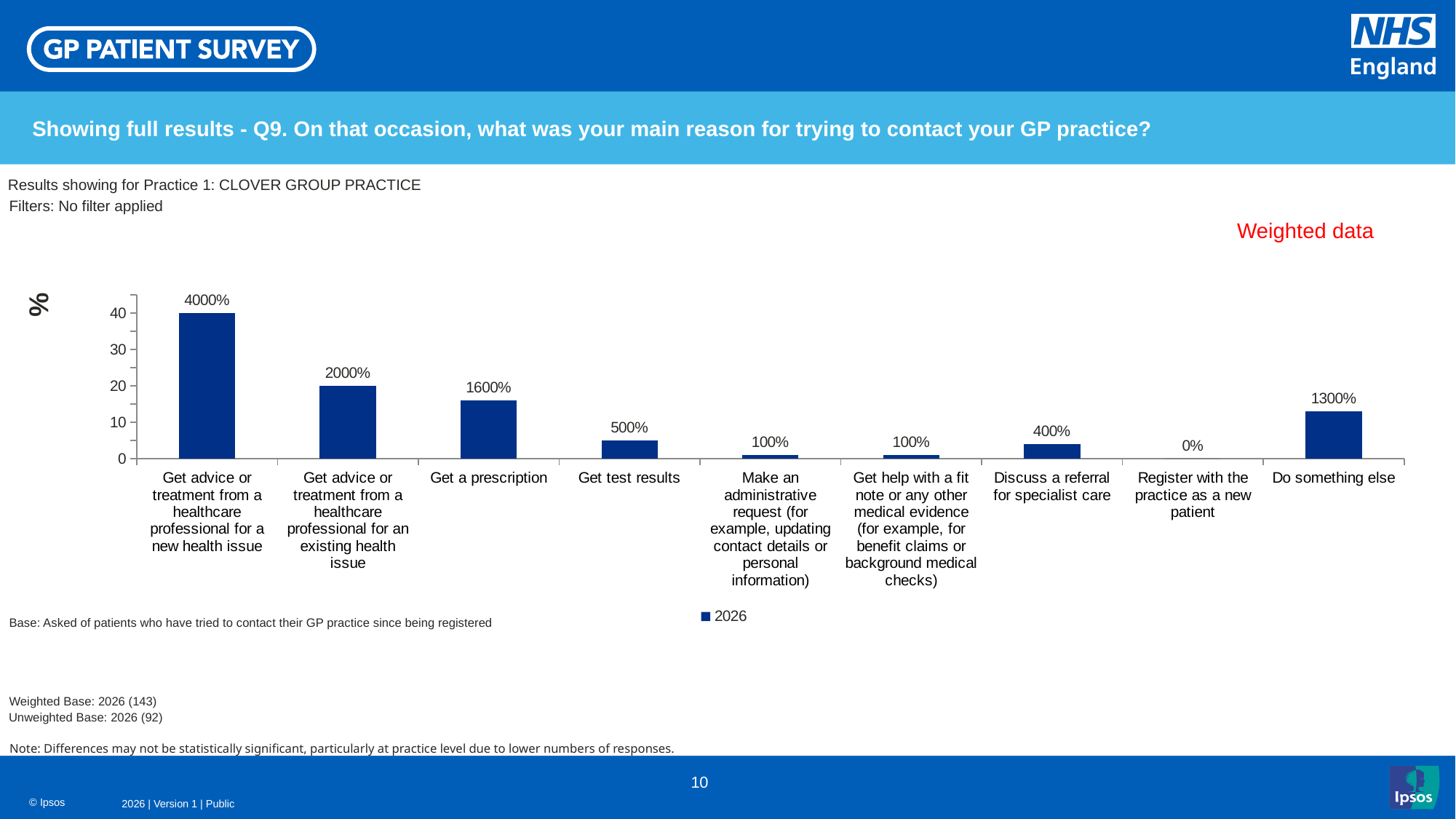
How many categories are shown on the x axis? 9 What is the difference between the labelled values for 'Get a prescription' and 'Get test results'? 1100% Which is larger: the value for 'Do something else' or the value for 'Discuss a referral for specialist care'? Do something else Which category has the lowest value? Register with the practice as a new patient Which category has the highest bar? Get advice or treatment from a healthcare professional for a new health issue What is the data label shown for 'Get test results'? 500% Is the bar for 'Get advice or treatment from a healthcare professional for an existing health issue' above or below the 30 mark on the axis? below What is the data label shown for 'Get a prescription'? 1600% What kind of chart is shown on the slide? bar chart What is the data label shown for 'Do something else'? 1300% What is the data label shown for 'Discuss a referral for specialist care'? 400% How many series does the legend list? 1